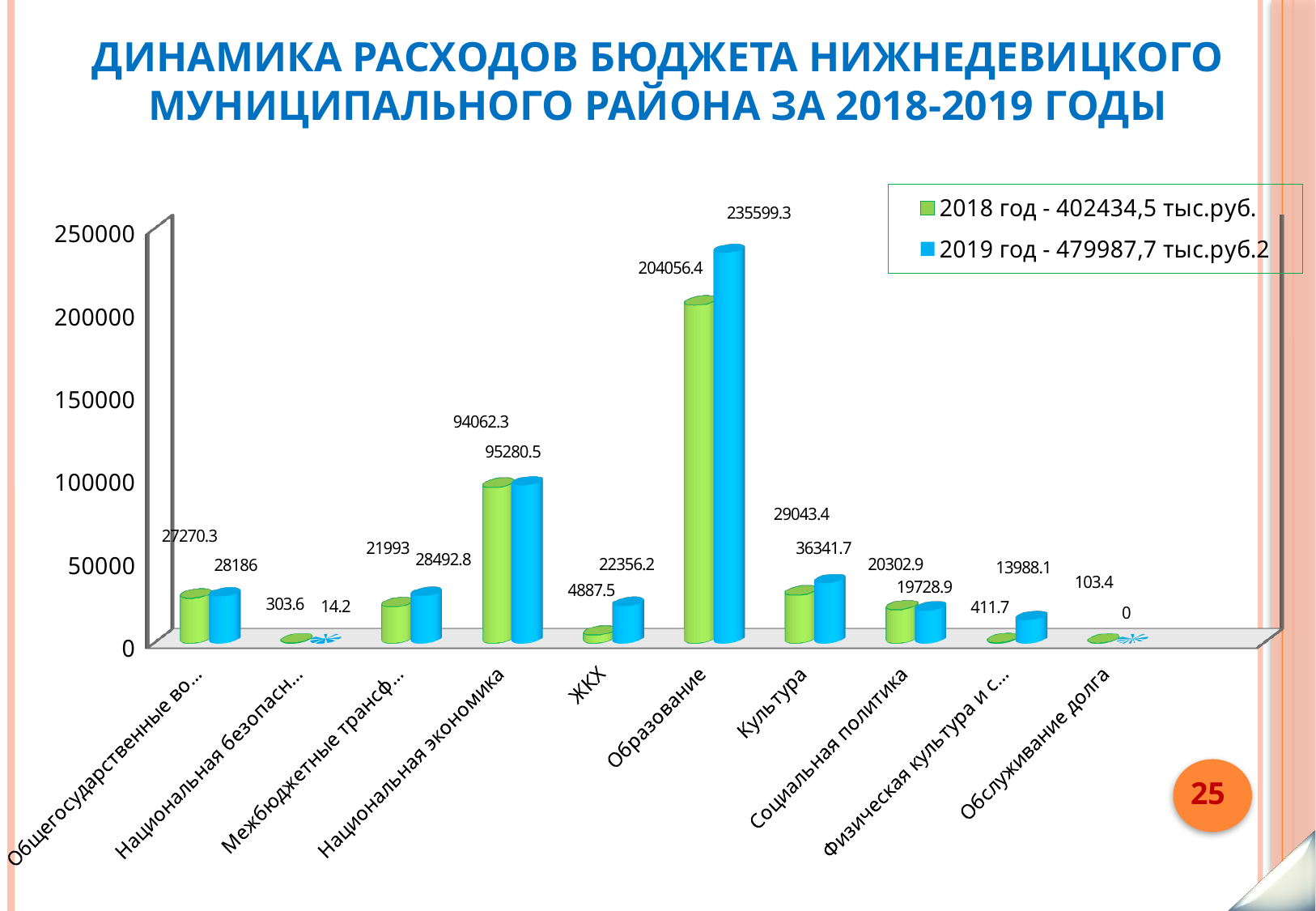
How many series does the legend list? 2 What is the difference between the 2019 and 2018 values for ЖКХ? 17468.7 What kind of chart is shown on the slide? bar chart Is the 2019 value for Национальная экономика greater or less than 100000? less What is the 2019 value for Образование? 235599.3 What is the 2019 value for Культура? 36341.7 What is the 2018 value for ЖКХ? 4887.5 For Социальная политика, which year has the larger value, 2018 or 2019? 2018 Which category has the lowest 2019 value? Обслуживание долга Which category has the highest 2018 value? Образование How many categories are shown on the x axis? 10 What is the difference between the 2019 and 2018 values for Образование? 31542.9